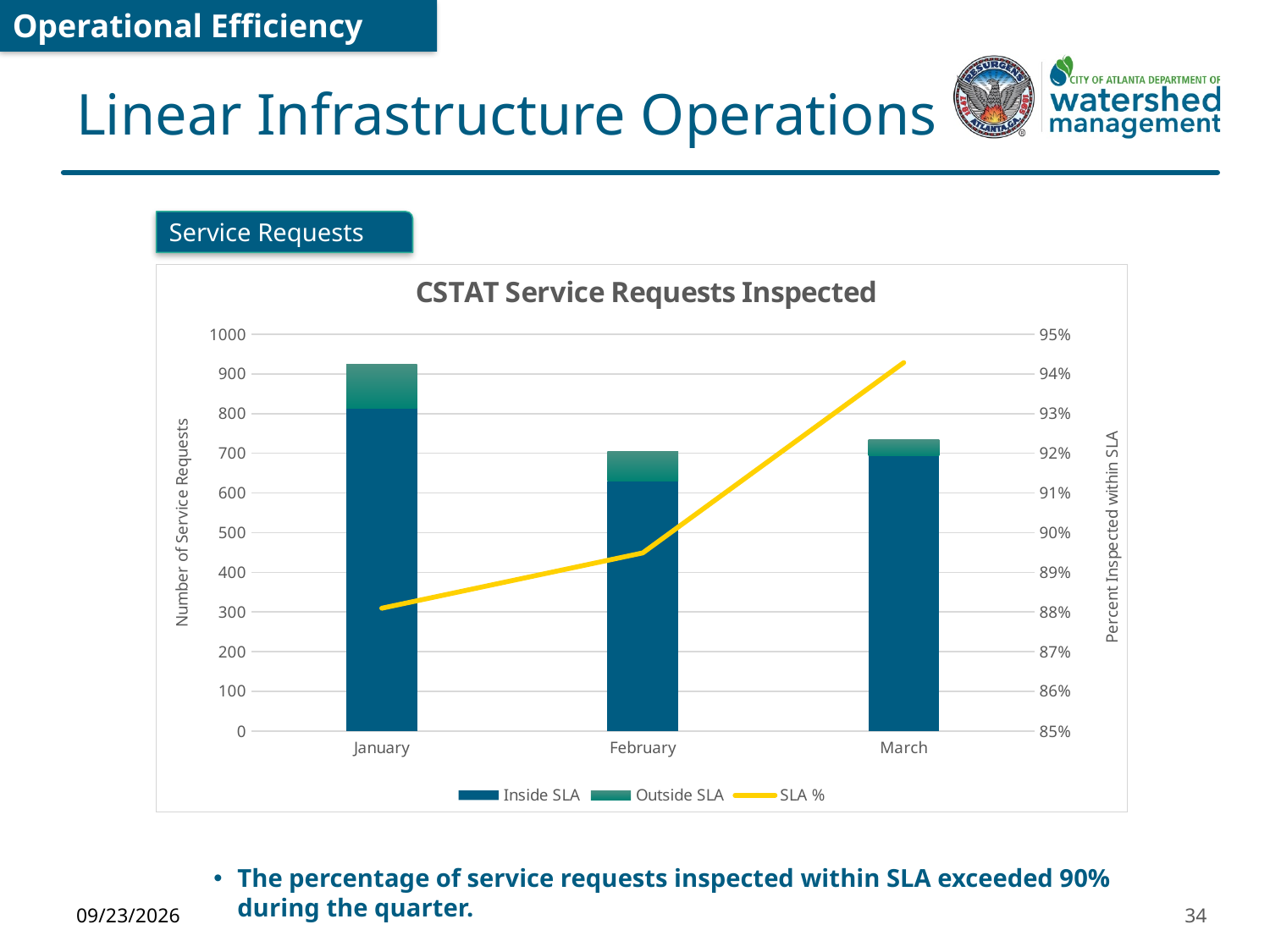
How many series does the legend of the CSTAT Service Requests Inspected chart list? 3 Is the SLA % value for March greater or less than 93%? greater Which month has the highest total number of service requests in the CSTAT Service Requests Inspected chart? January Is the total number of service requests for January greater or less than 900? greater What kind of chart is 'CSTAT Service Requests Inspected'? Combined bar and line chart Is the SLA % value for January greater or less than 89%? less Does the SLA % line rise or fall from January to March? rises What is the label of the right-hand vertical axis in the CSTAT Service Requests Inspected chart? Percent Inspected within SLA Which month has the lowest Inside SLA value in the CSTAT Service Requests Inspected chart? February How many months are shown on the x axis of the CSTAT Service Requests Inspected chart? 3 Which is larger, the Inside SLA value for January or the Inside SLA value for March? January